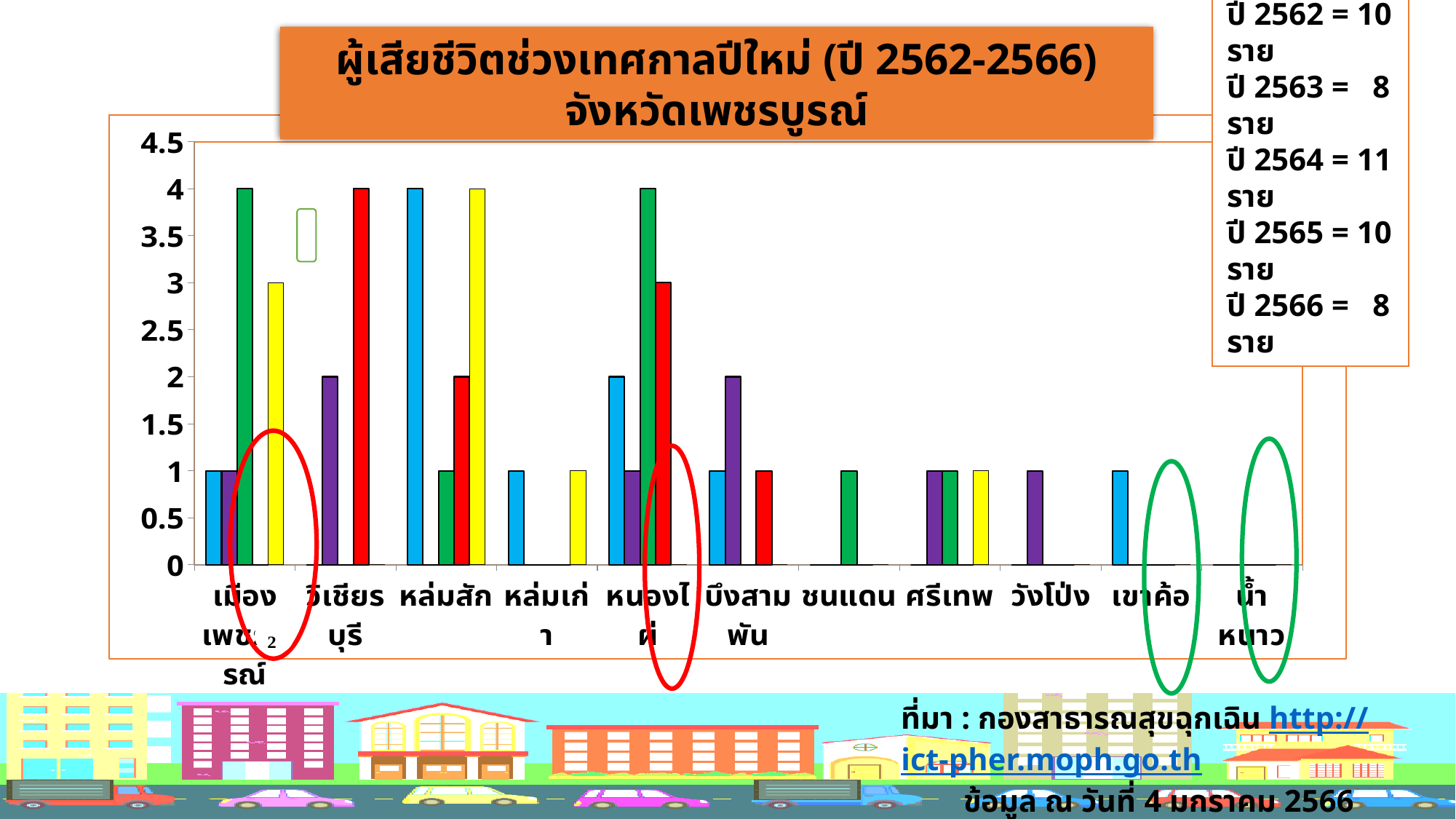
How many districts (categories) are shown along the x axis of the chart? 11 What is the value of the red bar for วิเชียรบุรี? 4 How many bars are plotted for ชนแดน? 1 According to the text box on the right, how many deaths were recorded in ปี 2564? 11 ราย Which has the taller red bar, หนองไผ่ or หล่มสัก? หนองไผ่ What is the value of the blue bar for หล่มสัก? 4 What is the value of the green bar for หนองไผ่? 4 What is the difference between the green bar and the yellow bar for เมืองเพชรบูรณ์? 1 What is the value of the yellow bar for เมืองเพชรบูรณ์? 3 What kind of chart is shown on the slide? bar chart What is the value of the purple bar for บึงสามพัน? 2 What is the title of the chart? ผู้เสียชีวิตช่วงเทศกาลปีใหม่ (ปี 2562-2566) จังหวัดเพชรบูรณ์